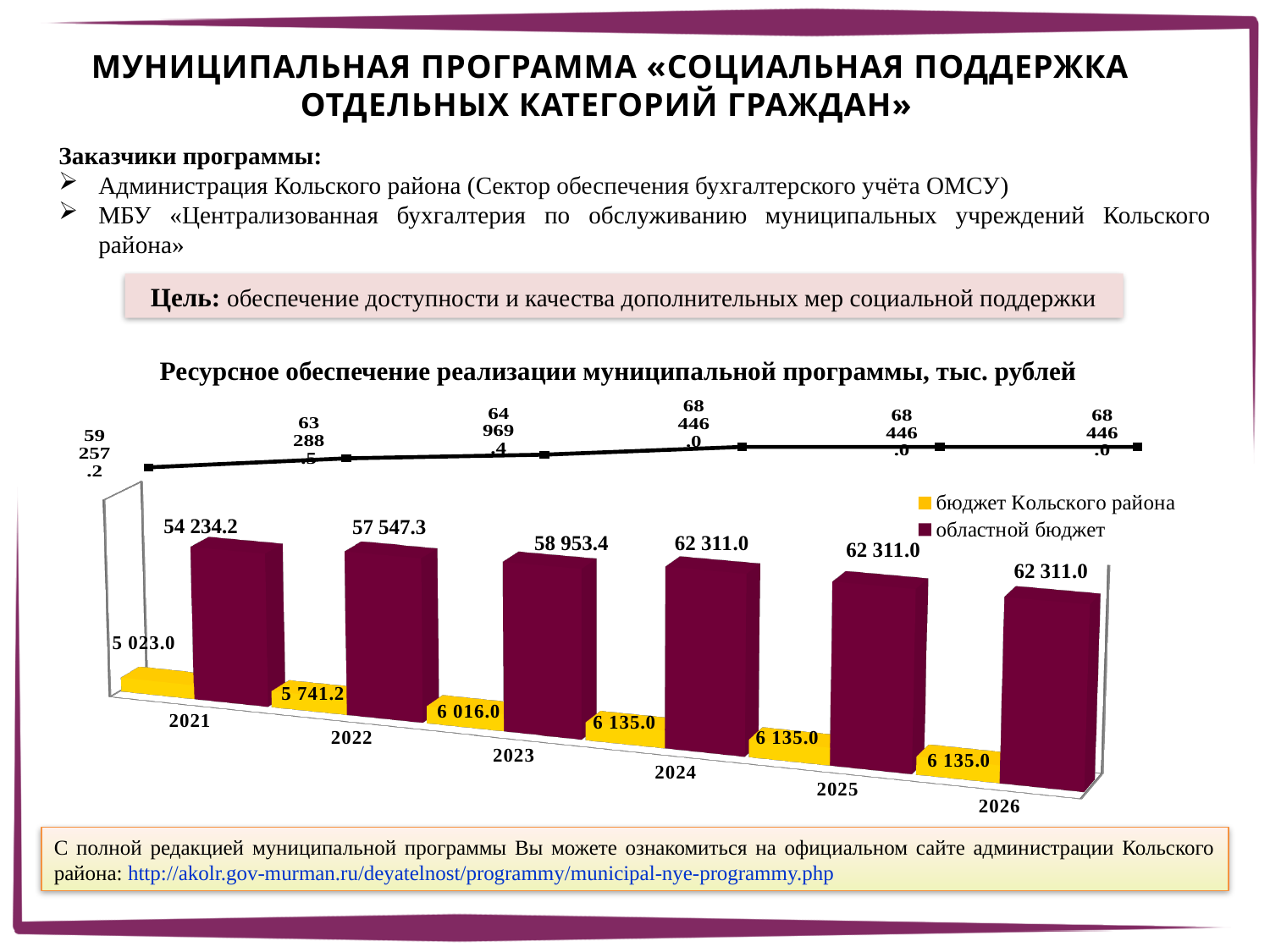
What is the value for бюджет Кольского района in 2022? 5 741.2 What is the value for областной бюджет in 2021? 54 234.2 What is the difference between the бюджет Кольского района values for 2024 and 2021? 1 112.0 How many series does the chart legend list? 2 What is the total of бюджет Кольского района and областной бюджет for 2021? 59 257.2 Which is larger: областной бюджет in 2023 or областной бюджет in 2022? областной бюджет in 2023 What is the value for областной бюджет in 2024? 62 311.0 What is the value for бюджет Кольского района in 2023? 6 016.0 In which year is the value for областной бюджет the lowest? 2021 How many years are shown on the x axis of the chart? 6 What is the difference between the областной бюджет values for 2022 and 2021? 3 313.1 In which year is the value for бюджет Кольского района the lowest? 2021